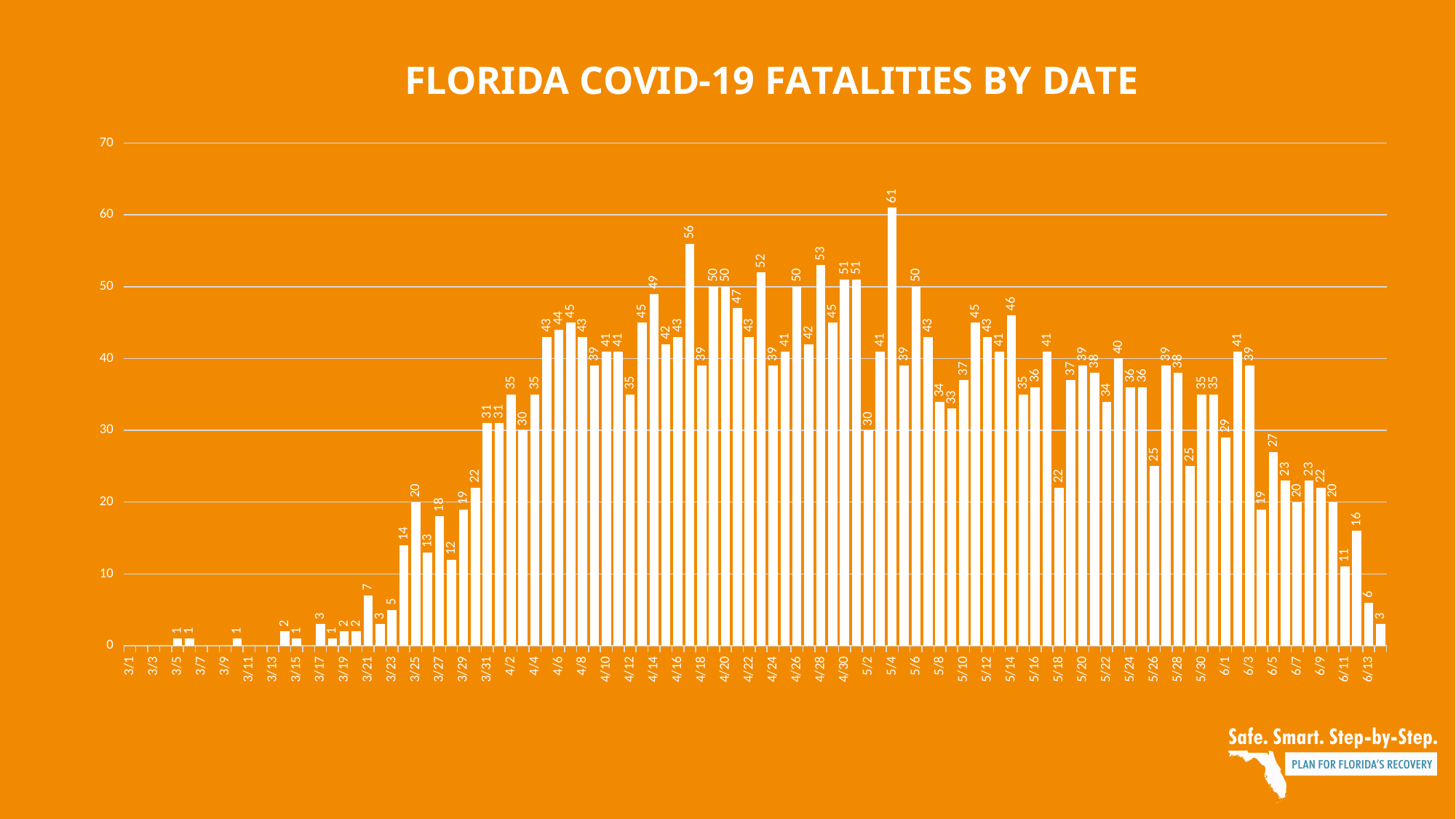
What is the value for 4/28? 53 Which is larger, the value for 4/14 or the value for 4/2? 4/14 What is the value for 6/13? 6 What is the value for 3/25? 20 Is the value for 4/6 greater or less than 40? greater What is the difference between the values for 5/4 and 4/28? 8 Which date has the highest number of fatalities? 5/4 What is the title of the chart? FLORIDA COVID-19 FATALITIES BY DATE What is the value for 5/4? 61 What is the value for 5/18? 22 What kind of chart is shown on the slide? bar chart Do the values rise or fall from 6/3 to 6/14? fall